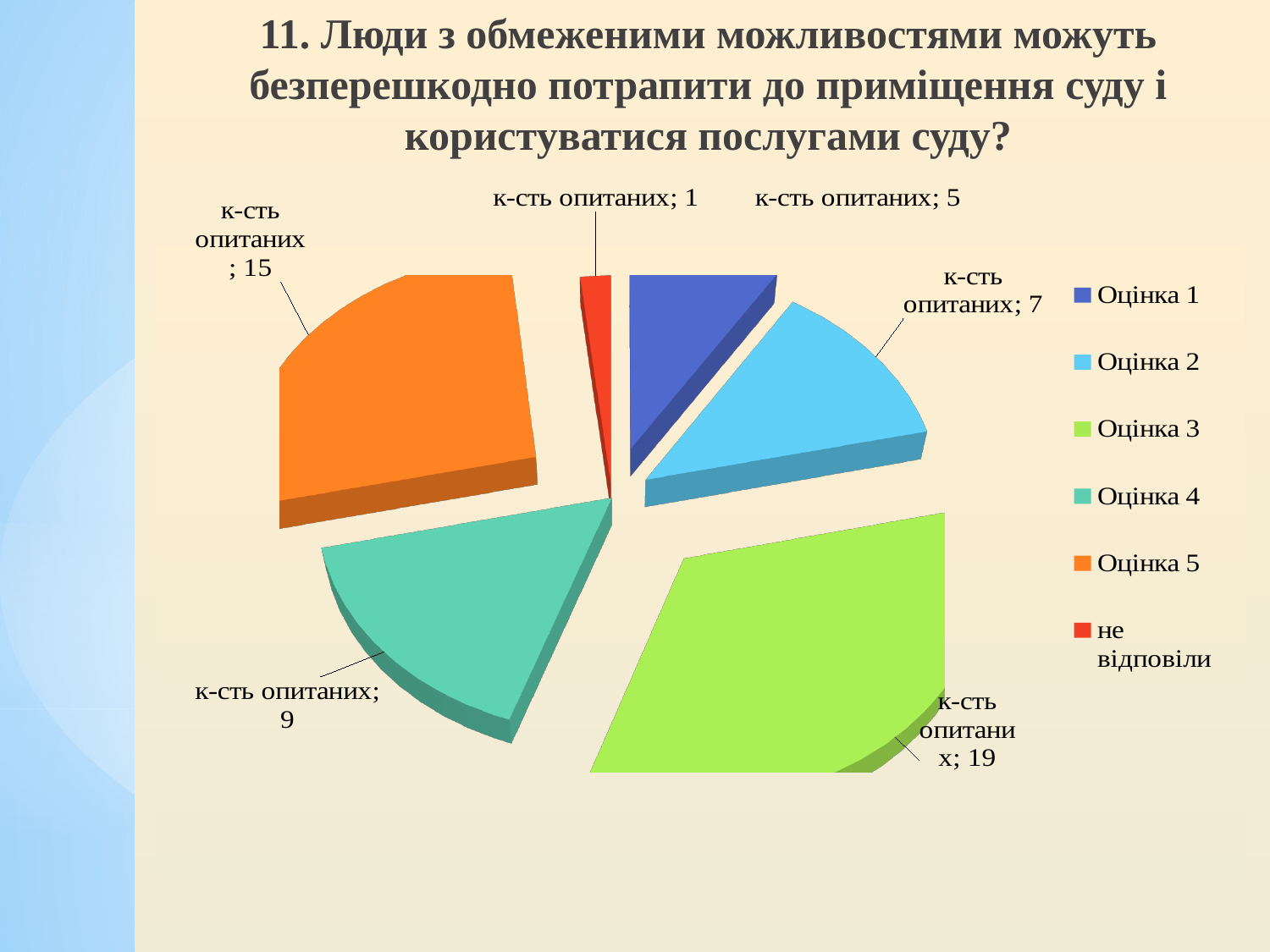
What is the difference between the number of respondents for Оцінка 3 and Оцінка 4? 10 How many respondents gave Оцінка 2? 7 How many respondents gave Оцінка 5? 15 How many respondents gave Оцінка 1? 5 Which category has the smallest slice of the pie? не відповіли What colour is the slice for Оцінка 4? teal (green-blue) How many respondents gave Оцінка 3? 19 How many respondents did not answer (не відповіли)? 1 How many categories does the legend list? 6 Which category has the largest slice of the pie? Оцінка 3 Which has more respondents, Оцінка 5 or Оцінка 2? Оцінка 5 What kind of chart is shown on the slide? pie chart